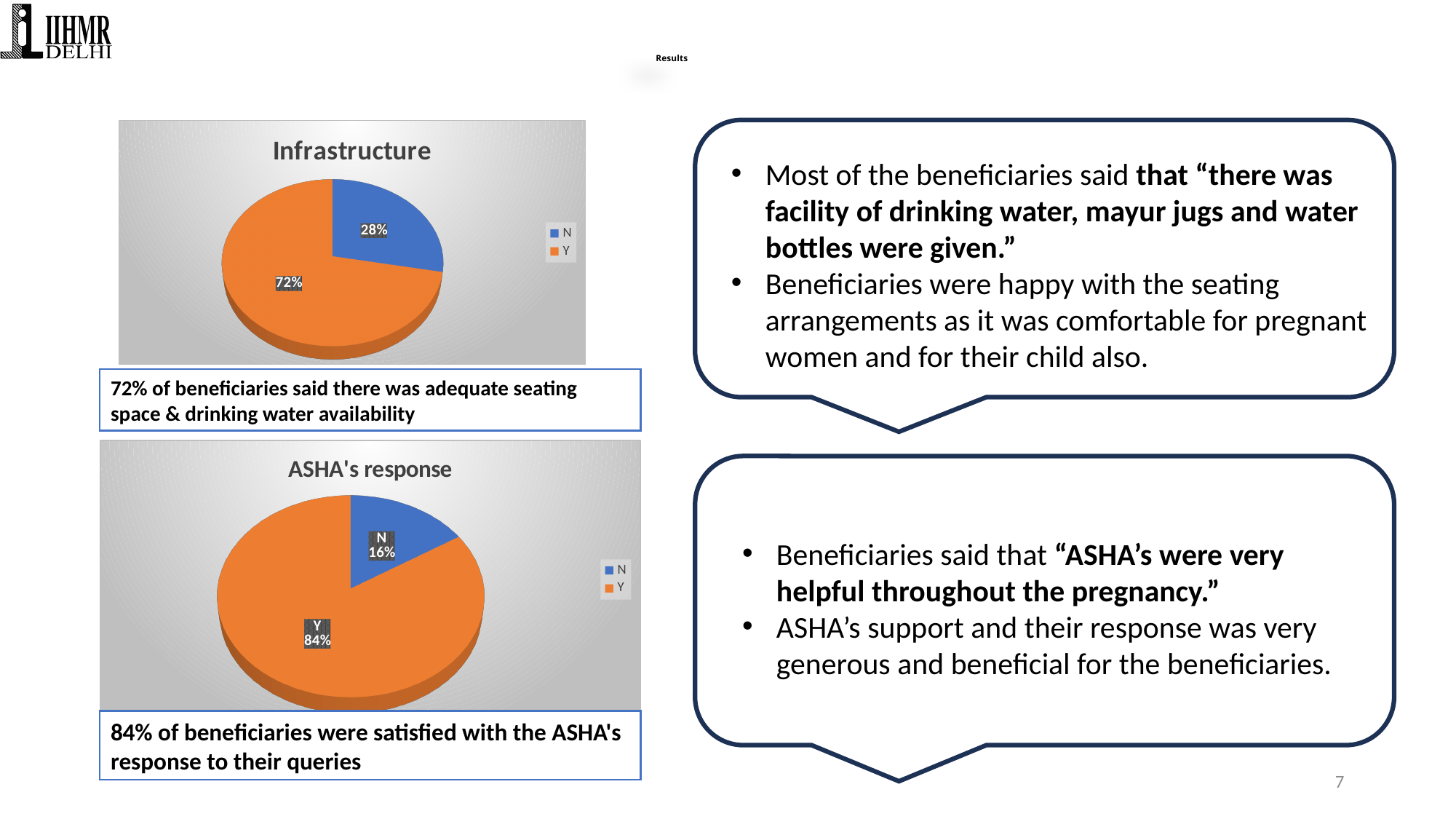
In the Infrastructure chart, what share of the pie is labelled Y? 72% In the ASHA's response chart, what share of the pie is labelled Y? 84% Which is larger: the N share in the Infrastructure chart or the N share in the ASHA's response chart? Infrastructure What type of chart is the Infrastructure chart? Pie chart In the Infrastructure chart, what is the difference between the Y and N shares? 44% In the ASHA's response chart, what is the difference between the Y and N shares? 68% In the Infrastructure chart, which category has the largest slice? Y In the Infrastructure chart, what share of the pie is labelled N? 28% In the ASHA's response chart, which category has the smallest slice? N In the Infrastructure chart, what colour is the Y slice? Orange How many categories does the legend of the ASHA's response chart list? 2